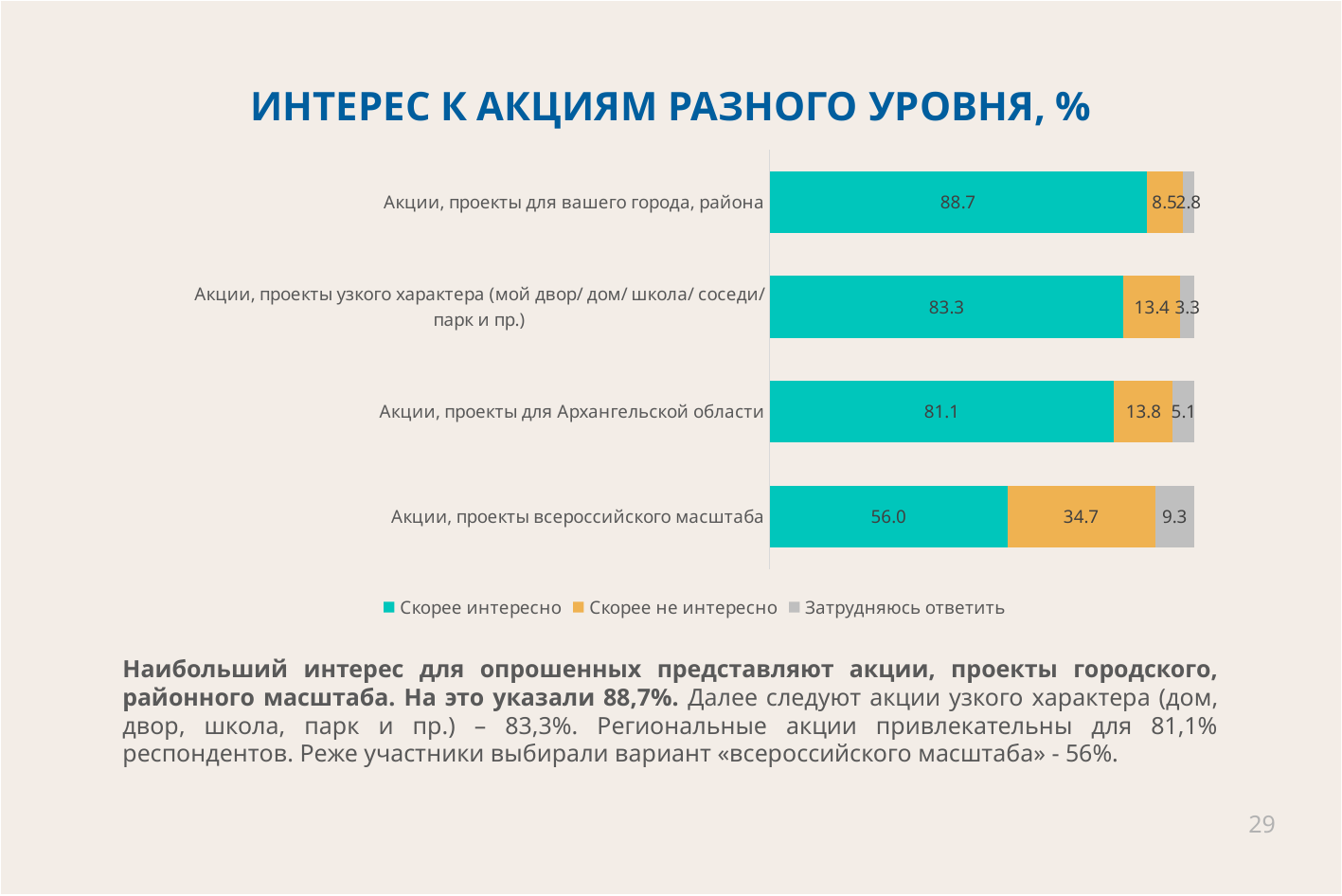
Which category has the lowest 'Скорее интересно' value? Акции, проекты всероссийского масштаба What is the difference between the 'Скорее интересно' values for 'Акции, проекты узкого характера' and 'Акции, проекты всероссийского масштаба'? 27.3 What is the 'Затрудняюсь ответить' value for 'Акции, проекты для Архангельской области'? 5.1 What type of chart is shown on the slide? Stacked bar chart How many series does the legend list? 3 Which category has the highest 'Скорее интересно' value? Акции, проекты для вашего города, района What is the title of the chart? ИНТЕРЕС К АКЦИЯМ РАЗНОГО УРОВНЯ, % How many categories are plotted in the chart? 4 What is the 'Скорее не интересно' value for 'Акции, проекты всероссийского масштаба'? 34.7 Which is larger: the 'Затрудняюсь ответить' value for 'Акции, проекты всероссийского масштаба' or for 'Акции, проекты для Архангельской области'? Акции, проекты всероссийского масштаба What is the 'Скорее интересно' value for 'Акции, проекты для вашего города, района'? 88.7 What is the 'Скорее не интересно' value for 'Акции, проекты узкого характера (мой двор/ дом/ школа/ соседи/ парк и пр.)'? 13.4